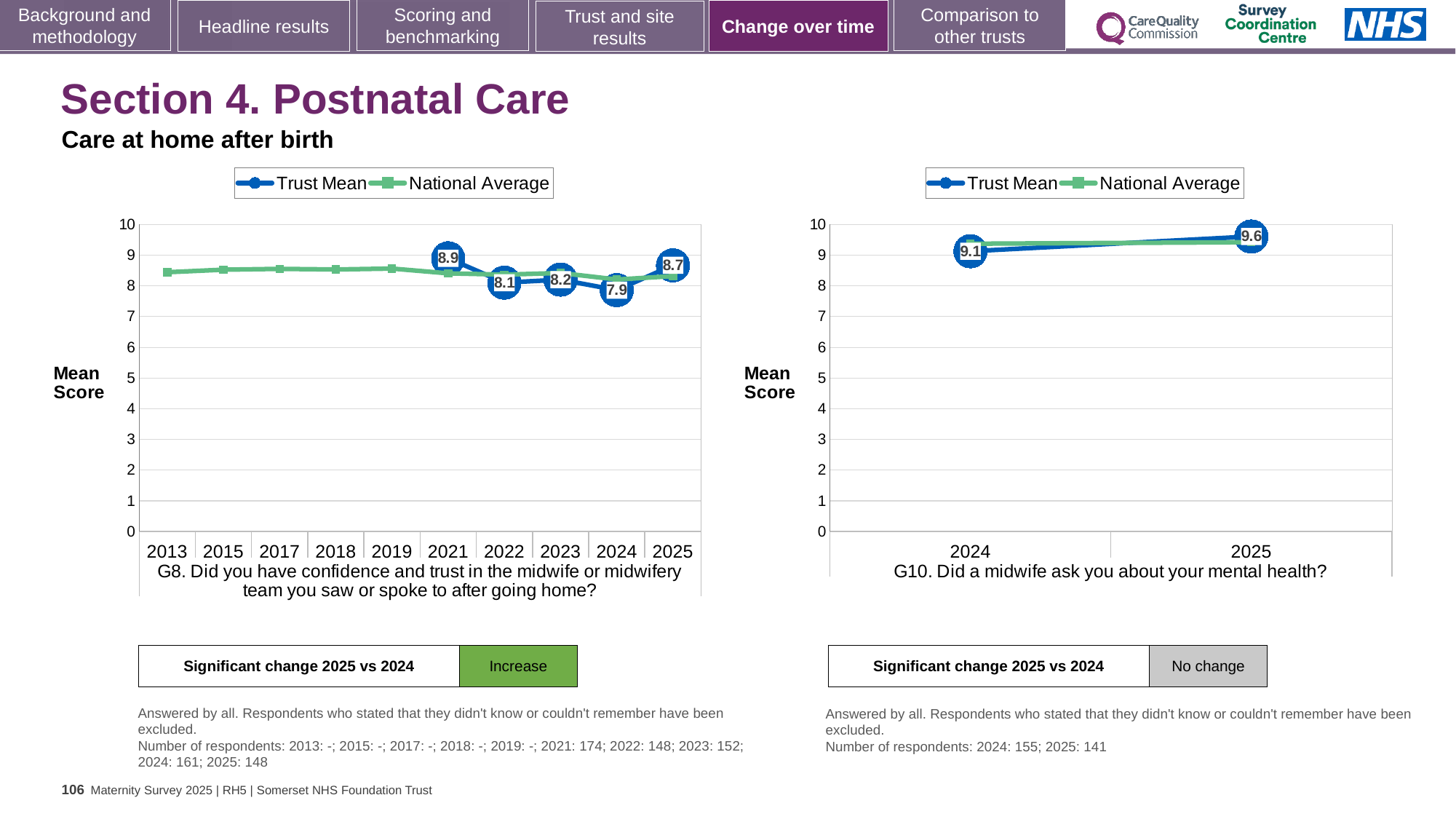
On the left chart (G8), in which year is the Trust Mean score highest? 2021 On the left chart (G8), is the National Average for 2013 greater or less than 8? greater On the right chart (G10), what is the difference between the Trust Mean scores for 2025 and 2024? 0.5 On the left chart (G8), in which year is the Trust Mean score lowest? 2024 What type of chart is the left chart (G8)? Line chart On the left chart (G8), what is the Trust Mean score for 2021? 8.9 On the left chart (G8), what is the difference between the Trust Mean scores for 2025 and 2024? 0.8 On the left chart (G8), is the Trust Mean score for 2022 or 2023 larger? 2023 On the left chart (G8), what is the Trust Mean score for 2025? 8.7 On the right chart (G10), what is the Trust Mean score for 2025? 9.6 On the left chart (G8), what is the Trust Mean score for 2024? 7.9 On the right chart (G10), how many years are shown on the x axis? 2